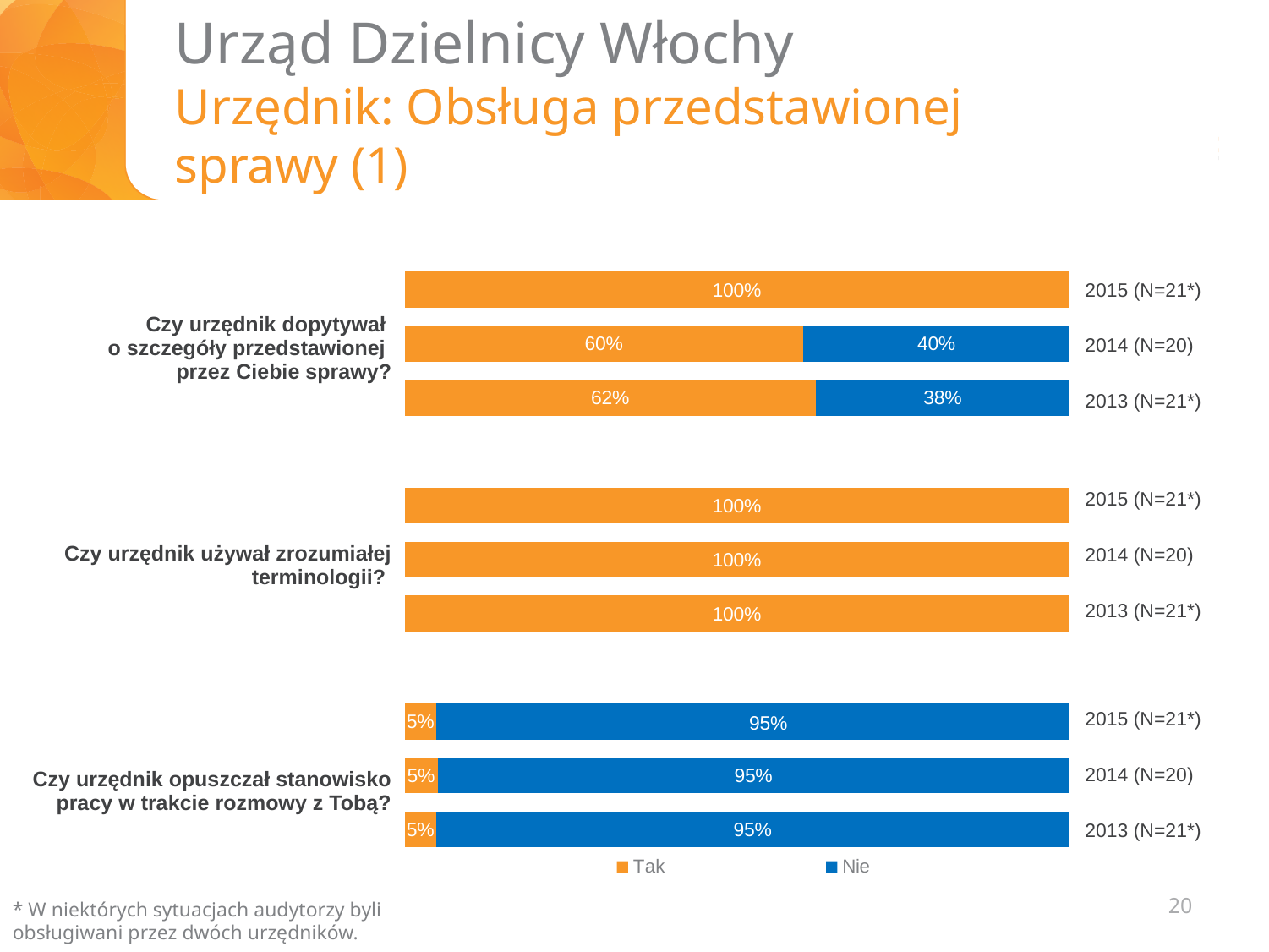
How many series does the legend list? 2 What share of respondents answered "Nie" to "Czy urzędnik opuszczał stanowisko pracy w trakcie rozmowy z Tobą?" in 2015 (N=21*)? 95% What share of respondents answered "Tak" to "Czy urzędnik dopytywał o szczegóły przedstawionej przez Ciebie sprawy?" in 2014 (N=20)? 60% What share of respondents answered "Nie" to "Czy urzędnik dopytywał o szczegóły przedstawionej przez Ciebie sprawy?" in 2013 (N=21*)? 38% For "Czy urzędnik dopytywał o szczegóły przedstawionej przez Ciebie sprawy?", what is the difference between the "Nie" share in 2014 (N=20) and in 2013 (N=21*)? 2 percentage points What share of respondents answered "Tak" to "Czy urzędnik używał zrozumiałej terminologii?" in 2013 (N=21*)? 100% For "Czy urzędnik dopytywał o szczegóły przedstawionej przez Ciebie sprawy?", what is the difference between the "Tak" share in 2015 (N=21*) and in 2014 (N=20)? 40 percentage points Which colour represents the "Nie" answer in the chart? Blue What share of respondents answered "Tak" to "Czy urzędnik dopytywał o szczegóły przedstawionej przez Ciebie sprawy?" in 2015 (N=21*)? 100% What kind of chart is shown on the slide? Stacked bar chart For "Czy urzędnik dopytywał o szczegóły przedstawionej przez Ciebie sprawy?", which year has the lowest "Tak" share? 2014 (N=20) For "Czy urzędnik dopytywał o szczegóły przedstawionej przez Ciebie sprawy?" in 2014 (N=20), which answer has the larger share, "Tak" or "Nie"? Tak